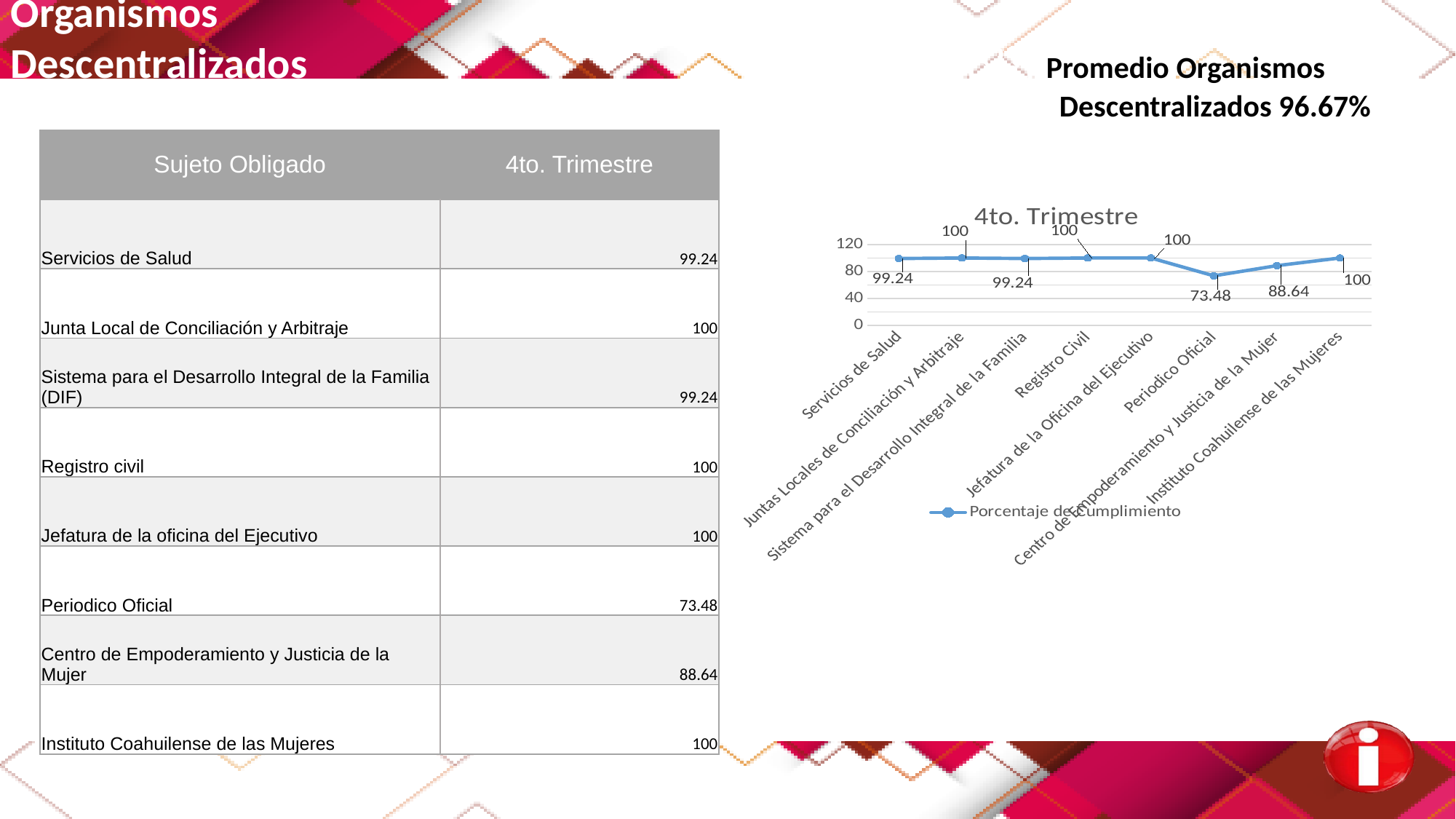
Is the value for Periodico Oficial greater or less than 80? less What type of chart is shown on the slide? line chart What is the value for Servicios de Salud in the chart? 99.24 What is the title of the chart? 4to. Trimestre How many series does the chart legend list? 1 What is the value for Centro de Empoderamiento y Justicia de la Mujer in the chart? 88.64 How many categories are plotted on the x axis of the chart? 8 Which category has the lowest value in the chart? Periodico Oficial Which is larger, the value for Centro de Empoderamiento y Justicia de la Mujer or the value for Periodico Oficial? Centro de Empoderamiento y Justicia de la Mujer What is the value for Periodico Oficial in the chart? 73.48 What is the difference between the values for Registro Civil and Periodico Oficial? 26.52 What is the name of the series shown in the chart legend? Porcentaje de Cumplimiento